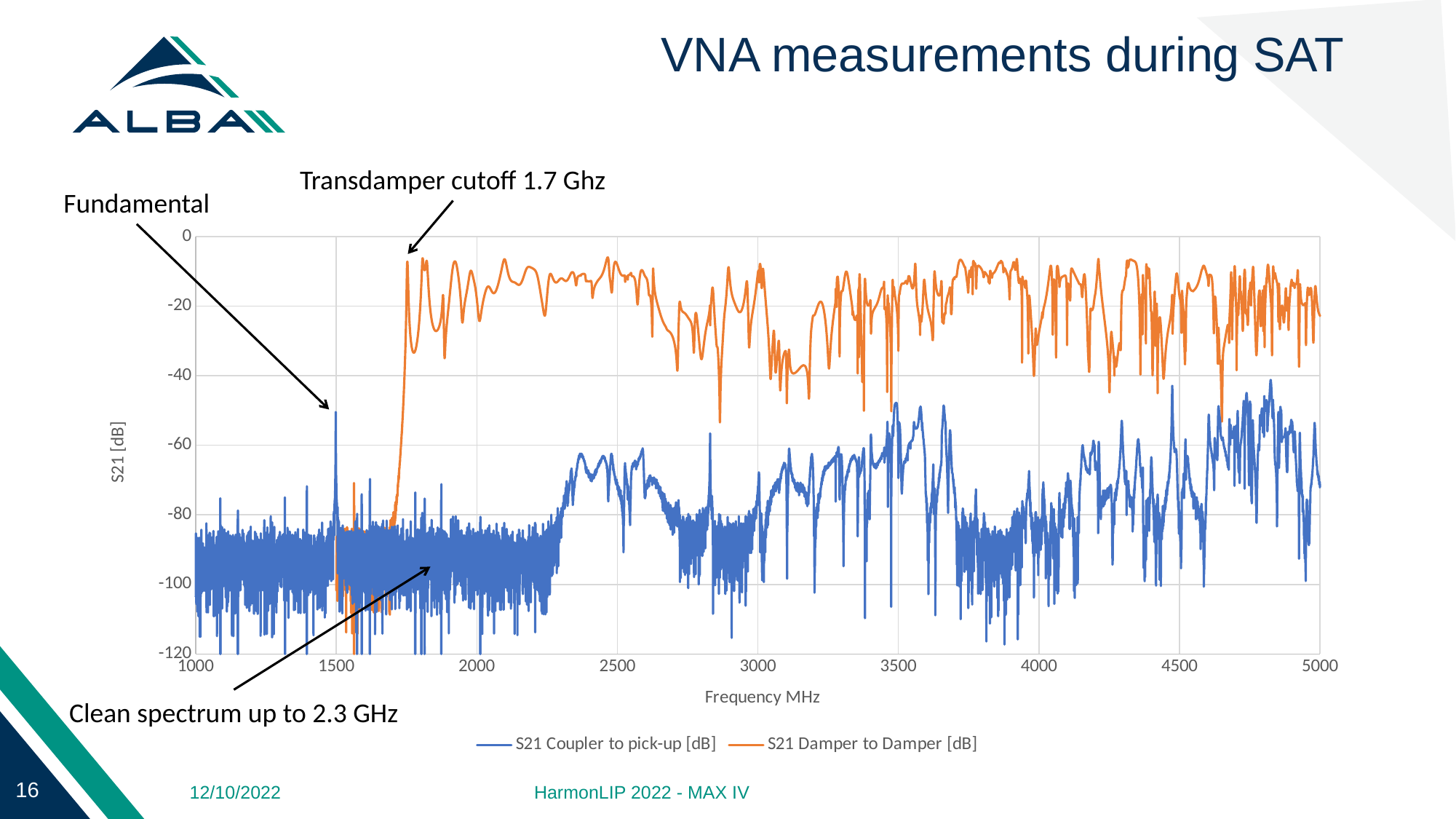
At 4000 MHz, which series has the lower S21 value: S21 Coupler to pick-up [dB] or S21 Damper to Damper [dB]? S21 Coupler to pick-up [dB] Is the value of the S21 Coupler to pick-up [dB] series at 1200 MHz greater or less than -60? less Is the value of the S21 Damper to Damper [dB] series at 2500 MHz greater or less than -40? greater What is the label of the chart's x axis? Frequency MHz Is the value of the S21 Damper to Damper [dB] series at 1200 MHz greater or less than -80? less Does the S21 Damper to Damper [dB] series rise or fall between 1700 MHz and 1800 MHz? rise What is the highest value shown on the chart's y axis? 0 At 3000 MHz, which series has the higher S21 value: S21 Coupler to pick-up [dB] or S21 Damper to Damper [dB]? S21 Damper to Damper [dB] How many series does the chart legend list? 2 Which series is drawn in orange according to the legend? S21 Damper to Damper [dB] What kind of chart is shown on the slide? line chart